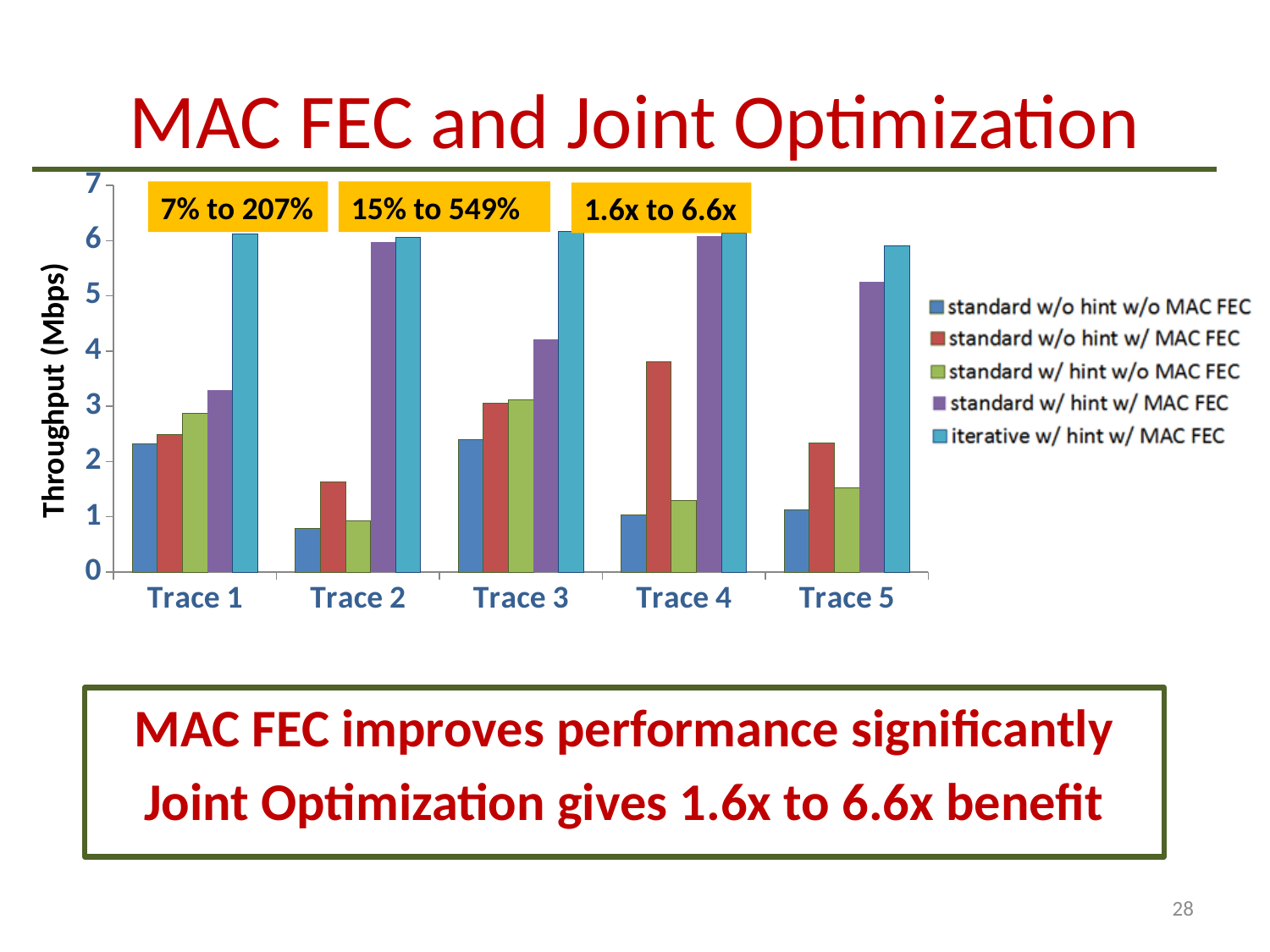
In Trace 5, which is larger: 'standard w/ hint w/ MAC FEC' or 'standard w/o hint w/ MAC FEC'? standard w/ hint w/ MAC FEC What is the label of the y axis? Throughput (Mbps) Is the value for 'standard w/o hint w/o MAC FEC' in Trace 2 greater or less than 1? less Is the value for 'iterative w/ hint w/ MAC FEC' in Trace 1 greater or less than 5? greater How many series does the legend list? 5 Which series has the lowest throughput in Trace 5? standard w/o hint w/o MAC FEC What kind of chart is shown on the slide? bar chart Is the value for 'standard w/o hint w/ MAC FEC' in Trace 4 greater or less than 3? greater How many traces (categories) are shown on the x axis? 5 Which series has the highest throughput in Trace 1? iterative w/ hint w/ MAC FEC In Trace 1, which is larger: 'standard w/ hint w/o MAC FEC' or 'standard w/o hint w/o MAC FEC'? standard w/ hint w/o MAC FEC